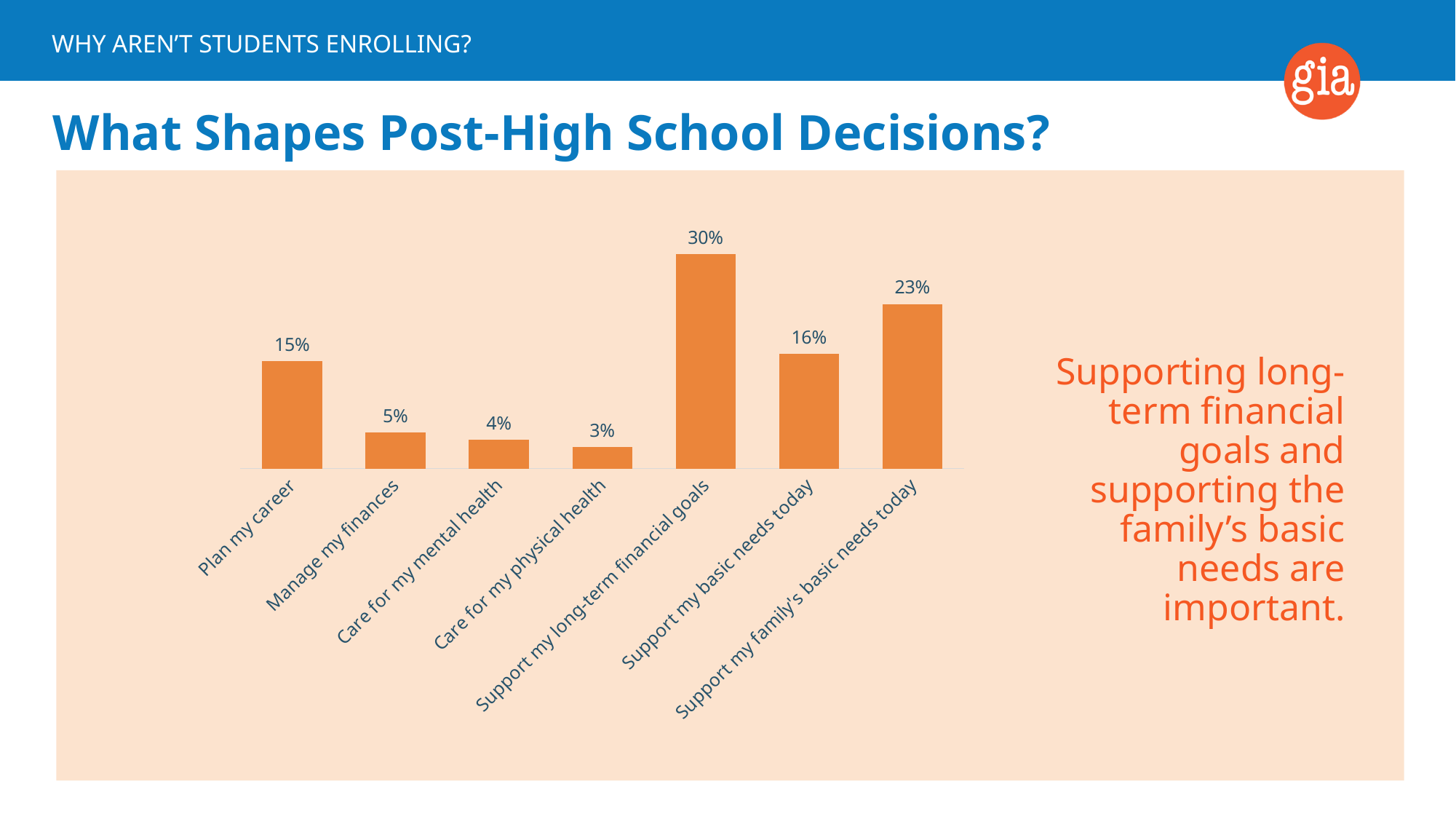
What is the value for "Support my family's basic needs today"? 23% What is the value for "Support my long-term financial goals"? 30% Which is larger, "Manage my finances" or "Care for my mental health"? Manage my finances What is the difference between "Support my basic needs today" and "Plan my career"? 1% What is the title of the slide above the chart? What Shapes Post-High School Decisions? Which category has the lowest value? Care for my physical health What kind of chart is shown on the slide? Bar chart What is the value for "Care for my physical health"? 3% How many categories are shown in the chart? 7 Which category has the highest value? Support my long-term financial goals What is the difference between "Support my long-term financial goals" and "Support my family's basic needs today"? 7% What is the value for "Plan my career"? 15%